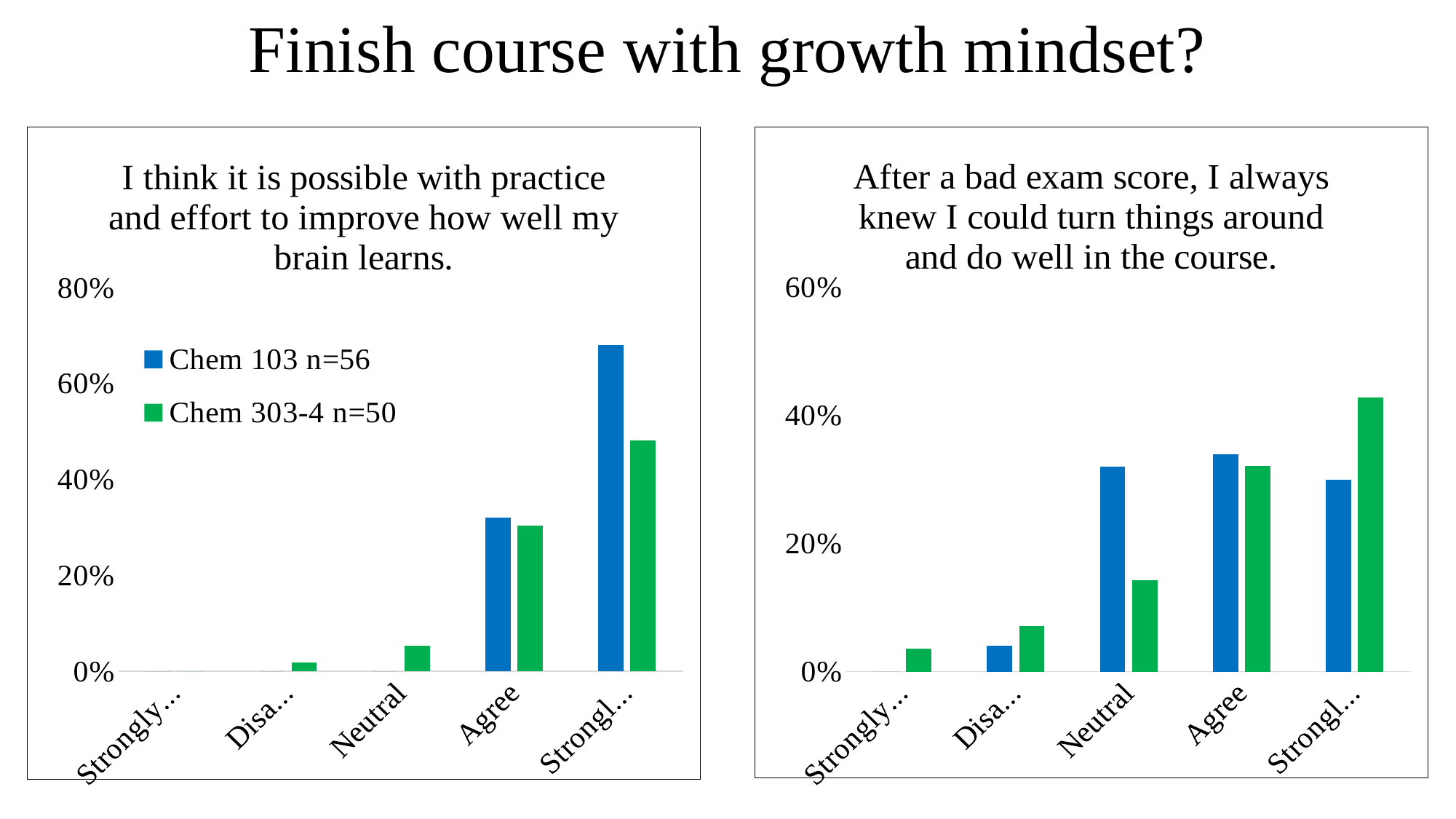
In the right chart, 'After a bad exam score, I always knew I could turn things around and do well in the course.', how many categories are shown on the x axis? 5 In the right chart, which series has the larger value at Neutral? Chem 103 n=56 In the left chart, which colour represents Chem 103 n=56? blue What kind of chart is the left chart, 'I think it is possible with practice and effort to improve how well my brain learns.'? bar chart In the right chart, is the value for Chem 103 n=56 at Neutral greater or less than 20%? greater In the right chart, is the value for Chem 303-4 n=50 at Neutral greater or less than 20%? less In the left chart, is the value for Chem 303-4 n=50 at Neutral greater or less than 20%? less In the left chart, which series has the larger value at Neutral? Chem 303-4 n=50 In the right chart, between Neutral and Agree, which category has the higher value for Chem 303-4 n=50? Agree In the left chart, how many series does the legend list? 2